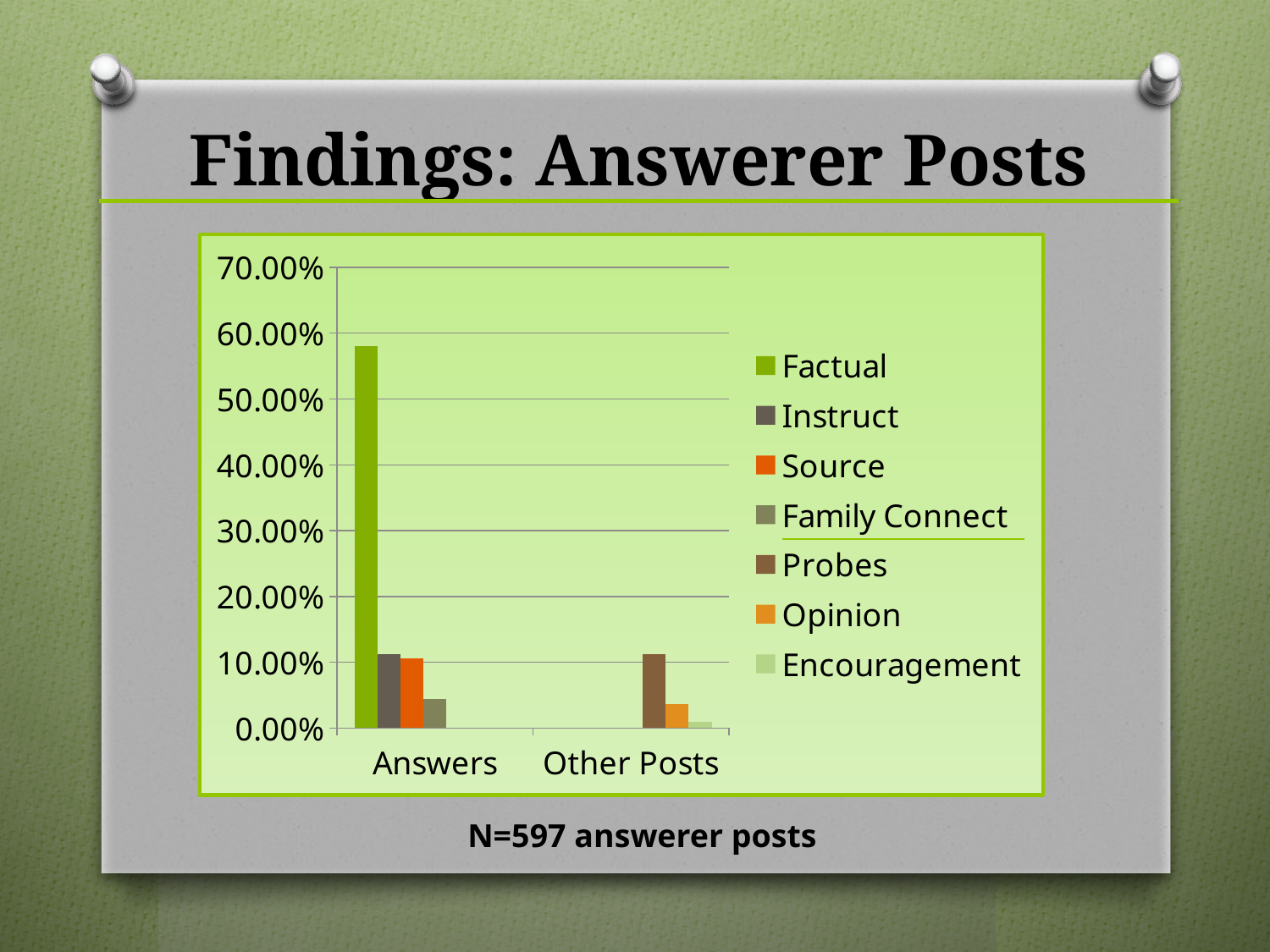
Is the value for Family Connect in the Answers category greater or less than 10.00%? less What is the title of the slide containing the chart? Findings: Answerer Posts How many categories are shown on the x axis of the chart? 2 Which is larger in the Other Posts category, Probes or Encouragement? Probes Which is larger in the Answers category, Factual or Instruct? Factual Is the value for Factual in the Answers category greater or less than 60.00%? less Is the value for Factual in the Answers category greater or less than 50.00%? greater Which series appears in the Other Posts category with the tallest bar? Probes How many series does the chart's legend list? 7 Which series has the tallest bar in the chart? Factual What kind of chart is shown on the slide? bar chart